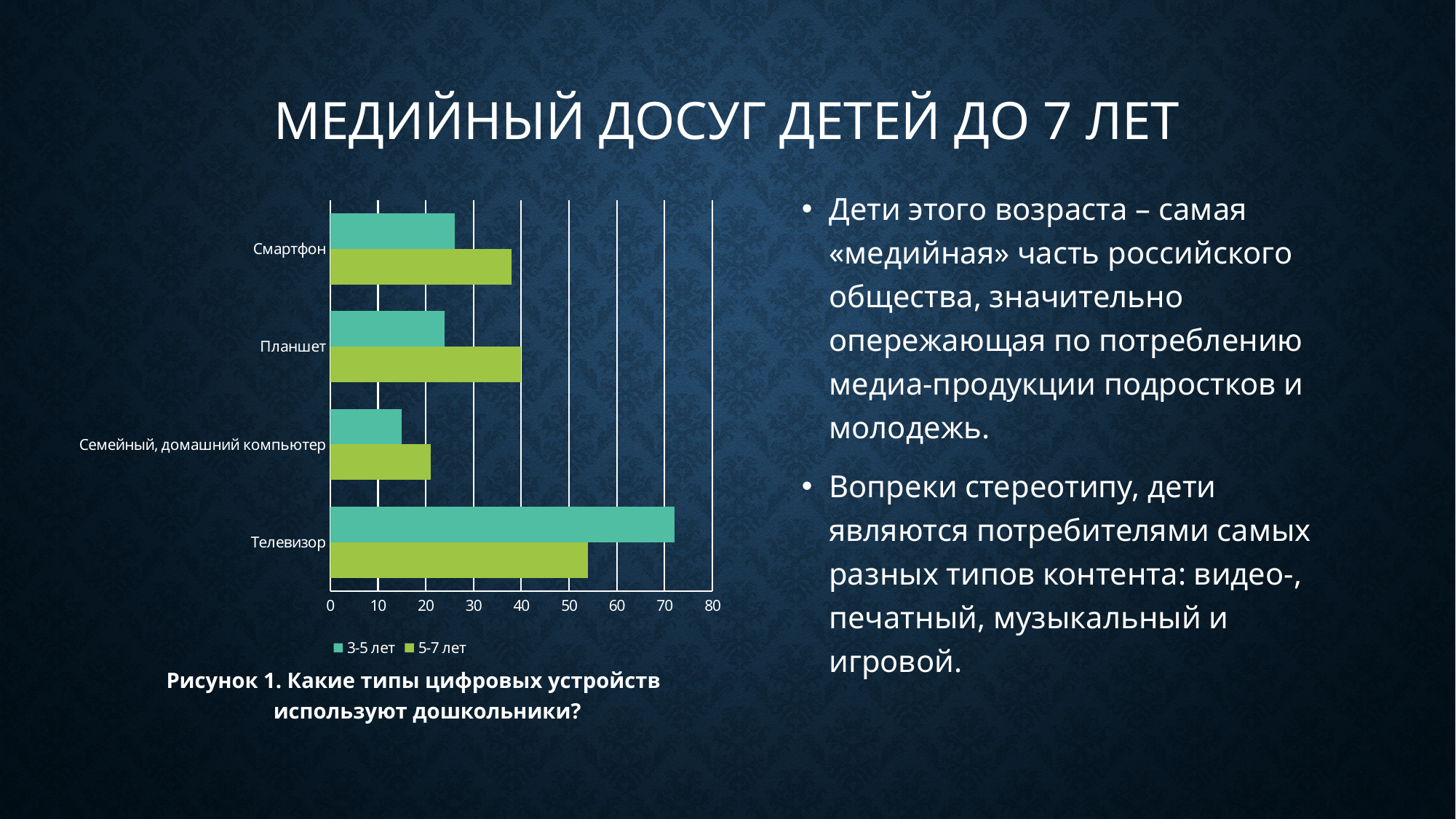
For Планшет, which series has the larger value: 3-5 лет or 5-7 лет? 5-7 лет Which device category has the lowest value for the 5-7 лет series? Семейный, домашний компьютер Is the value for Телевизор in the 3-5 лет series greater or less than 70? greater What kind of chart is shown on the slide? bar chart Which device category has the highest value for the 3-5 лет series? Телевизор Which device category has the highest value for the 5-7 лет series? Телевизор How many series does the chart legend list? 2 For Телевизор, which series has the larger value: 3-5 лет or 5-7 лет? 3-5 лет Is the value for Семейный, домашний компьютер in the 3-5 лет series greater or less than 20? less How many device categories are shown on the chart? 4 What is the caption given below the chart? Рисунок 1. Какие типы цифровых устройств используют дошкольники? Which device category has the lowest value for the 3-5 лет series? Семейный, домашний компьютер